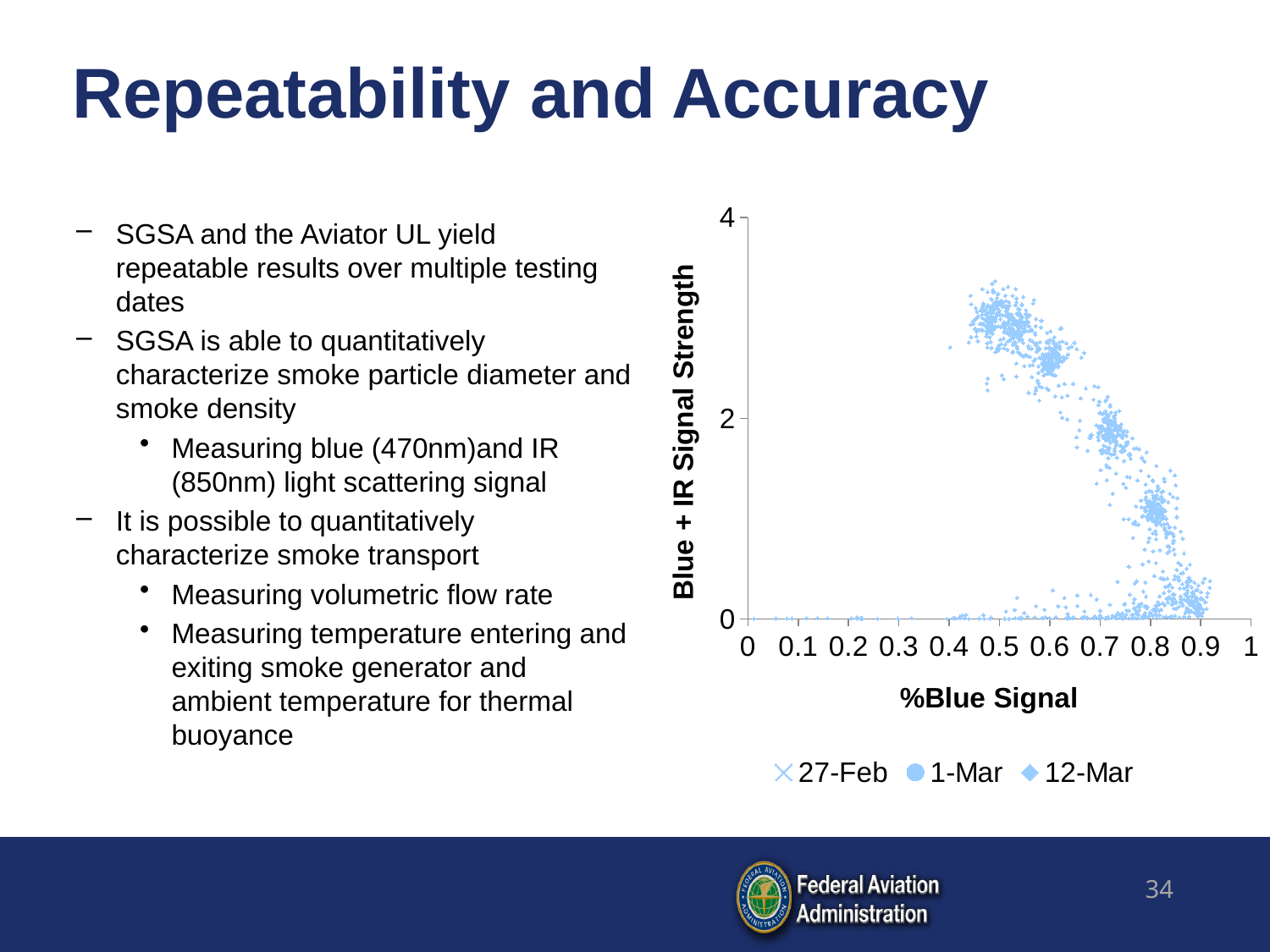
What are the series names listed in the chart legend? 27-Feb, 1-Mar, 12-Mar Is the highest plotted Blue + IR Signal Strength value greater or less than 2? greater Are the points with the highest Blue + IR Signal Strength located at a %Blue Signal greater or less than 0.7? less How many series does the chart legend list? 3 What is the title of the chart's x axis? %Blue Signal What is the maximum value shown on the chart's x axis? 1 As %Blue Signal increases from about 0.5 to 0.9, do the plotted Blue + IR Signal Strength values generally rise or fall? Fall What is the maximum value shown on the chart's y axis? 4 Is the highest plotted Blue + IR Signal Strength value greater or less than 4? less What kind of chart is shown on the slide? Scatter chart